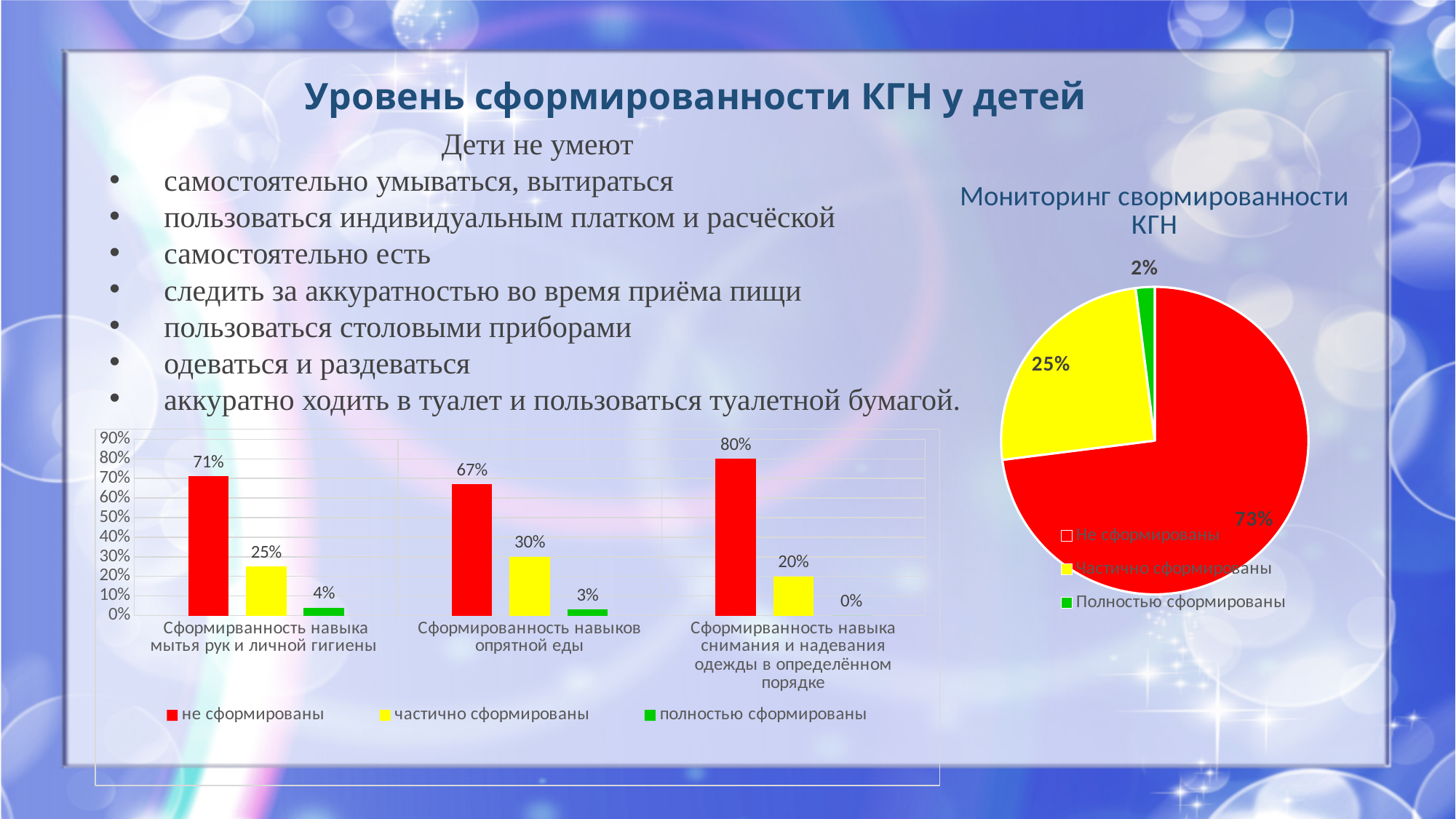
In the bar chart at the bottom left, which category has the lowest value for 'частично сформированы'? Сформирванность навыка снимания и надевания одежды в определённом порядке In the bar chart at the bottom left, what is the difference between 'не сформированы' and 'частично сформированы' for 'Сформированность навыков опрятной еды'? 37% In the bar chart at the bottom left, what is the value of 'частично сформированы' for 'Сформирванность навыка мытья рук и личной гигиены'? 25% In the bar chart at the bottom left, what is the value of 'полностью сформированы' for 'Сформирванность навыка снимания и надевания одежды в определённом порядке'? 0% In the bar chart at the bottom left, what is the value of 'не сформированы' for 'Сформированность навыков опрятной еды'? 67% In the bar chart at the bottom left, which category has the highest value for 'не сформированы'? Сформирванность навыка снимания и надевания одежды в определённом порядке In the pie chart 'Мониторинг сформированности КГН', which slice is the smallest? Полностью сформированы What type of chart is the chart titled 'Мониторинг сформированности КГН' on the right? Pie chart How many series does the legend of the bar chart at the bottom left list? 3 In the pie chart 'Мониторинг сформированности КГН', what share does 'Не сформированы' have? 73% How many categories are shown on the x axis of the bar chart at the bottom left? 3 In the bar chart at the bottom left, is the 'полностью сформированы' value higher for 'Сформирванность навыка мытья рук и личной гигиены' or for 'Сформированность навыков опрятной еды'? Сформирванность навыка мытья рук и личной гигиены